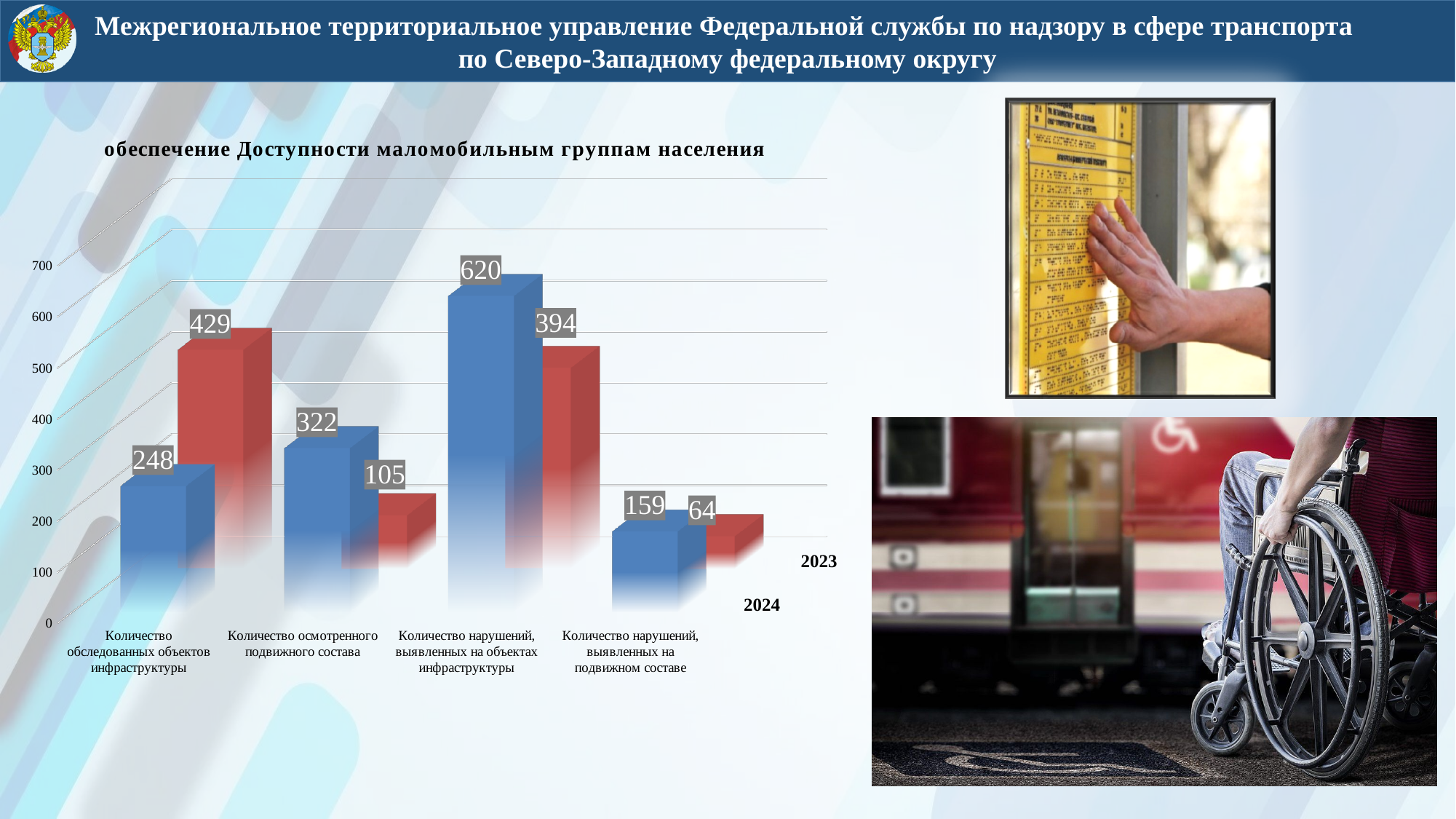
What is the difference between the 2024 and 2023 values for 'Количество осмотренного подвижного состава'? 217 Which category has the lowest 2023 value? Количество нарушений, выявленных на подвижном составе Which category has the highest 2024 value? Количество нарушений, выявленных на объектах инфраструктуры What is the title of the chart? обеспечение Доступности маломобильным группам населения What is the 2024 value for 'Количество обследованных объектов инфраструктуры'? 248 How many categories are shown on the chart's x axis? 4 What is the 2023 value for 'Количество нарушений, выявленных на подвижном составе'? 64 How many series (years) does the chart show? 2 What kind of chart is shown on the slide? bar chart What is the 2024 value for 'Количество нарушений, выявленных на объектах инфраструктуры'? 620 For 'Количество обследованных объектов инфраструктуры', which year has the larger value, 2023 or 2024? 2023 What is the 2023 value for 'Количество обследованных объектов инфраструктуры'? 429